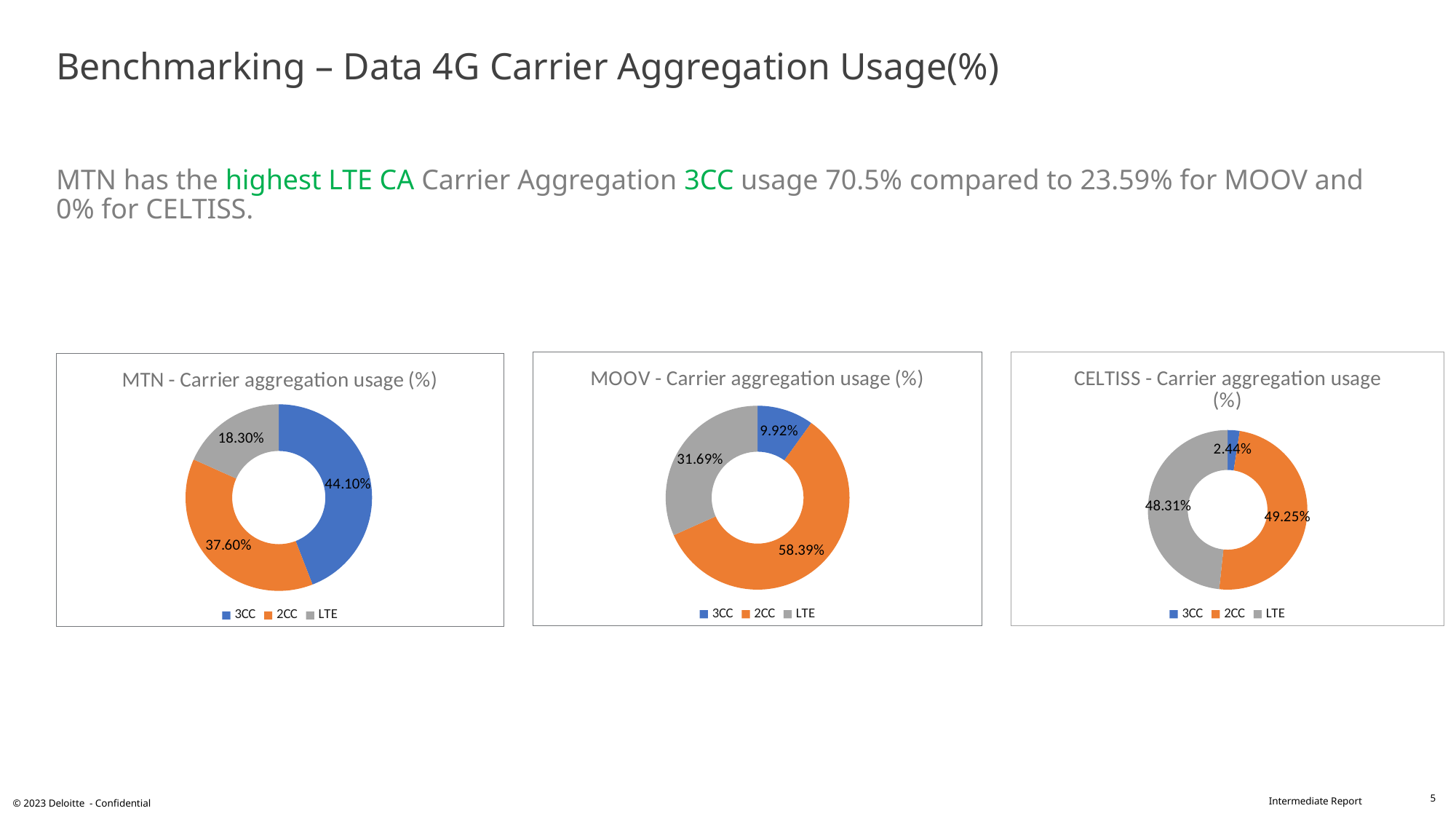
In the CELTISS - Carrier aggregation usage (%) chart, what is the value for LTE? 48.31% In the CELTISS - Carrier aggregation usage (%) chart, which category has the smallest share? 3CC In the MTN - Carrier aggregation usage (%) chart, which category has the largest share? 3CC In the MOOV - Carrier aggregation usage (%) chart, which category has the largest share? 2CC In the MTN - Carrier aggregation usage (%) chart, what is the value for 3CC? 44.10% How many categories does the CELTISS - Carrier aggregation usage (%) chart show? 3 How many charts are shown on the slide? 3 In the MTN - Carrier aggregation usage (%) chart, what is the difference between the 3CC and 2CC values? 6.50% In the MOOV - Carrier aggregation usage (%) chart, what is the value for 2CC? 58.39% What kind of chart is the MTN - Carrier aggregation usage (%) chart? doughnut chart In the MOOV - Carrier aggregation usage (%) chart, which is larger, LTE or 3CC? LTE In the MOOV - Carrier aggregation usage (%) chart, what is the value for 3CC? 9.92%